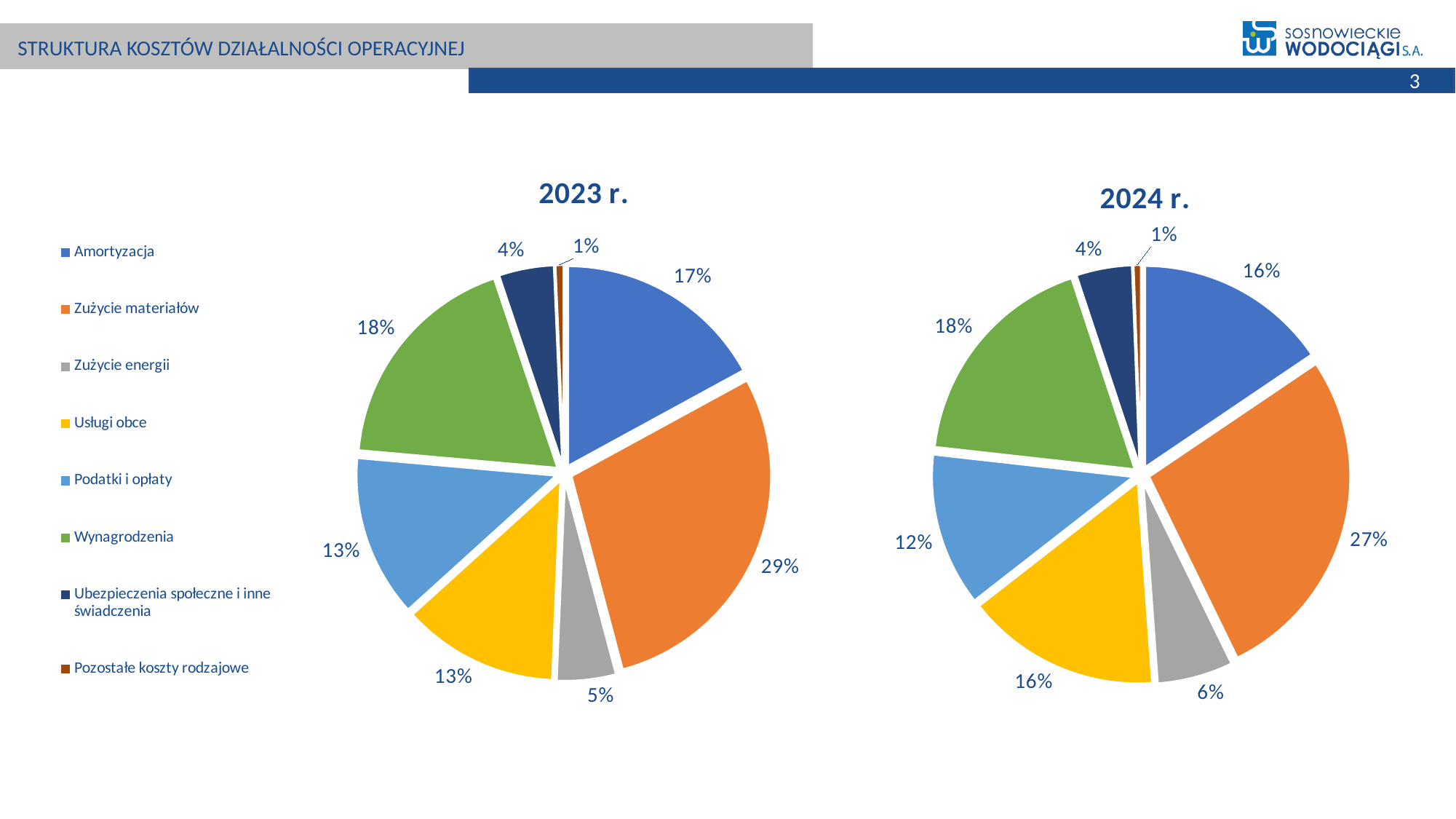
In the 2024 r. chart, what share does Usługi obce have? 16% What is the title of the left chart? 2023 r. In the 2023 r. chart, which category has the largest share? Zużycie materiałów In the 2023 r. chart, what share does Zużycie materiałów have? 29% In the 2024 r. chart, what share does Zużycie energii have? 6% Which legend entry is shown in green? Wynagrodzenia What is the difference between the share of Zużycie materiałów in the 2023 r. chart and in the 2024 r. chart? 2 percentage points In the 2024 r. chart, which is larger: Wynagrodzenia or Podatki i opłaty? Wynagrodzenia What type of chart is the 2024 r. chart? Pie chart In the 2024 r. chart, which category has the smallest share? Pozostałe koszty rodzajowe How many categories does the 2023 r. pie chart show? 8